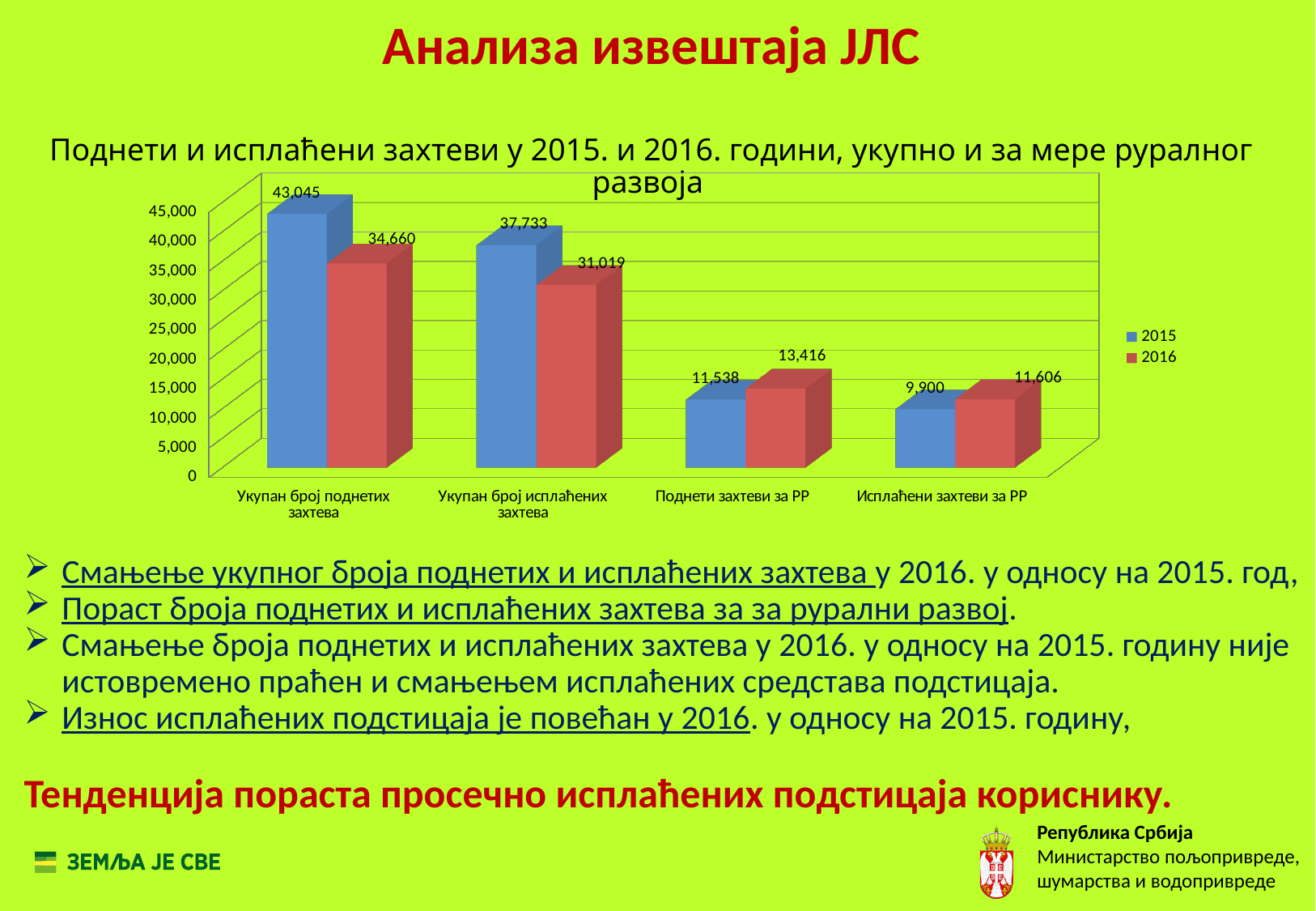
What is the difference between the 2015 and 2016 values for "Укупан број поднетих захтева"? 8,385 What is the 2015 value for "Исплаћени захтеви за РР"? 9,900 How many series does the legend list? 2 What is the 2015 value for "Укупан број поднетих захтева"? 43,045 Which category has the lowest 2016 value? Исплаћени захтеви за РР Which category has the highest 2015 value? Укупан број поднетих захтева What kind of chart is shown on the slide? Bar chart What is the 2016 value for "Поднети захтеви за РР"? 13,416 How many categories are shown on the x axis? 4 What is the 2016 value for "Укупан број исплаћених захтева"? 31,019 Which colour represents the 2016 series in the chart? Red Which is larger for "Поднети захтеви за РР": the 2015 value or the 2016 value? 2016